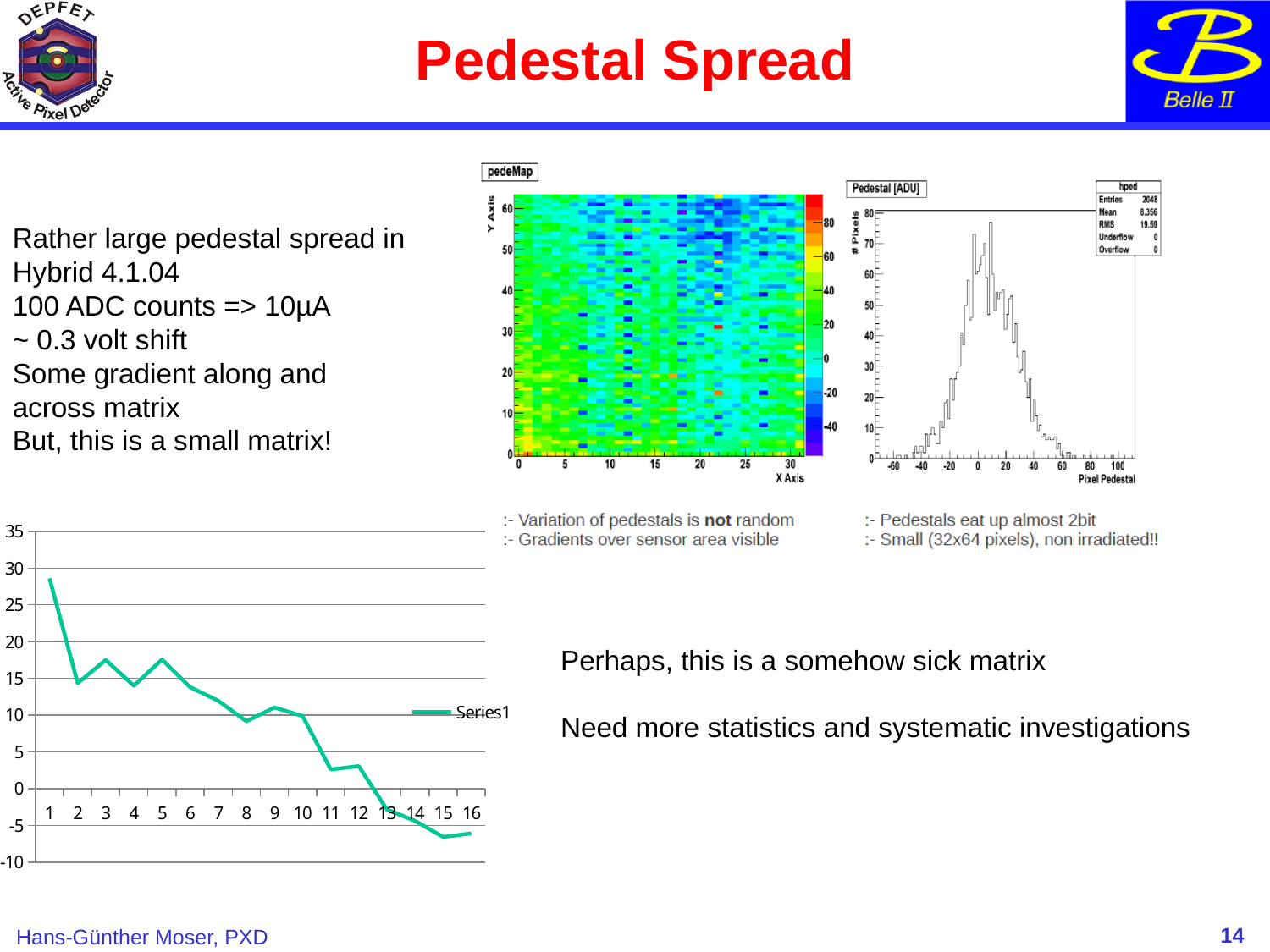
In the bottom-left line chart, is the value for category 14 greater or less than 0? less How many series does the legend of the bottom-left line chart list? 1 What kind of chart is the chart at the bottom left of the slide? line chart How many points are plotted along the x axis of the bottom-left line chart? 16 In the bottom-left line chart, is the value for category 1 greater or less than 25? greater In the bottom-left line chart, which has the larger value, category 1 or category 2? category 1 In the Pedestal [ADU] histogram at the top right, how many entries are listed in the statistics box? 2048 In the bottom-left line chart, which x-axis category has the highest value? 1 What is the name of the series shown in the legend of the bottom-left line chart? Series1 In the bottom-left line chart, is the value for category 11 greater or less than 5? less In the bottom-left line chart, do the values generally rise or fall from category 1 to category 16? fall In the bottom-left line chart, which has the larger value, category 5 or category 10? category 5